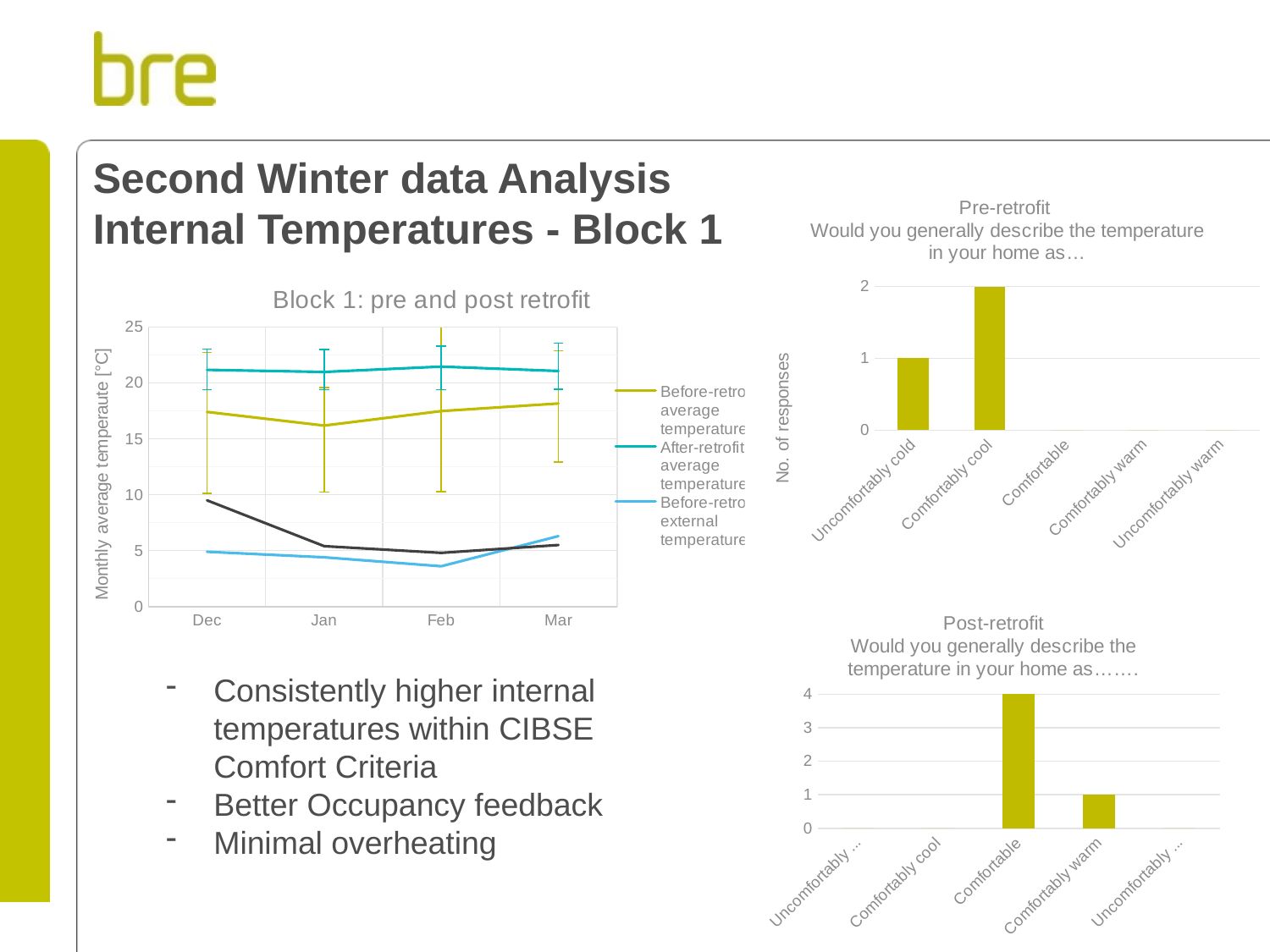
In the Post-retrofit chart, how many categories are shown on the x axis? 5 In the 'Block 1: pre and post retrofit' chart, what kind of chart is it? line chart In the Pre-retrofit chart, how many responses were 'Comfortably cool'? 2 In the 'Block 1: pre and post retrofit' chart, what is the y-axis label? Monthly average temperaute [°C] In the 'Block 1: pre and post retrofit' chart, is the After-retrofit average temperature in Dec greater or less than 20? greater In the Post-retrofit chart, how many responses were 'Comfortable'? 4 In the 'Block 1: pre and post retrofit' chart, which is higher in Jan: the After-retrofit average temperature or the Before-retro average temperature? After-retrofit average temperature In the Pre-retrofit chart, how many responses were 'Uncomfortably cold'? 1 In the 'Block 1: pre and post retrofit' chart, is the Before-retro external temperature in Feb greater or less than 5? less In the Pre-retrofit chart, which category has the most responses? Comfortably cool In the Post-retrofit chart, what is the difference between the number of 'Comfortable' responses and 'Comfortably warm' responses? 3 In the 'Block 1: pre and post retrofit' chart, how many months are shown on the x axis? 4